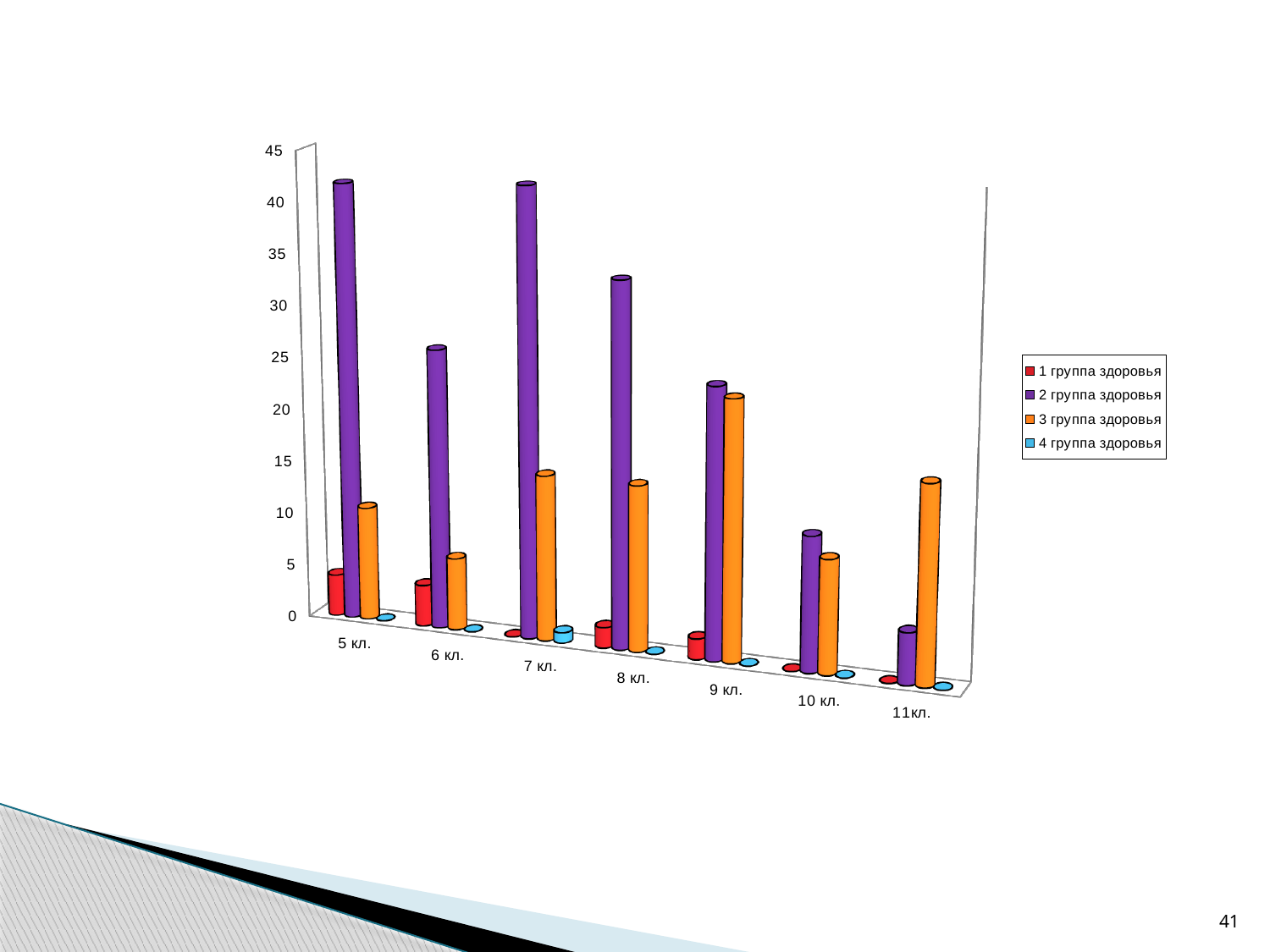
Is the value for 2 группа здоровья in 5 кл. greater or less than 35? greater What kind of chart is shown on the slide? bar chart Is the value for 2 группа здоровья in 10 кл. greater or less than 15? less How many series does the legend list? 4 In 11кл., which is larger: 2 группа здоровья or 3 группа здоровья? 3 группа здоровья Do the values for 2 группа здоровья rise or fall from 8 кл. to 11кл.? fall Is the value for 3 группа здоровья in 9 кл. greater or less than 15? greater In 8 кл., which is larger: 2 группа здоровья or 3 группа здоровья? 2 группа здоровья How many class categories are shown on the x axis? 7 Which class has the highest value for 3 группа здоровья? 9 кл. Which class has the lowest value for 2 группа здоровья? 11кл.